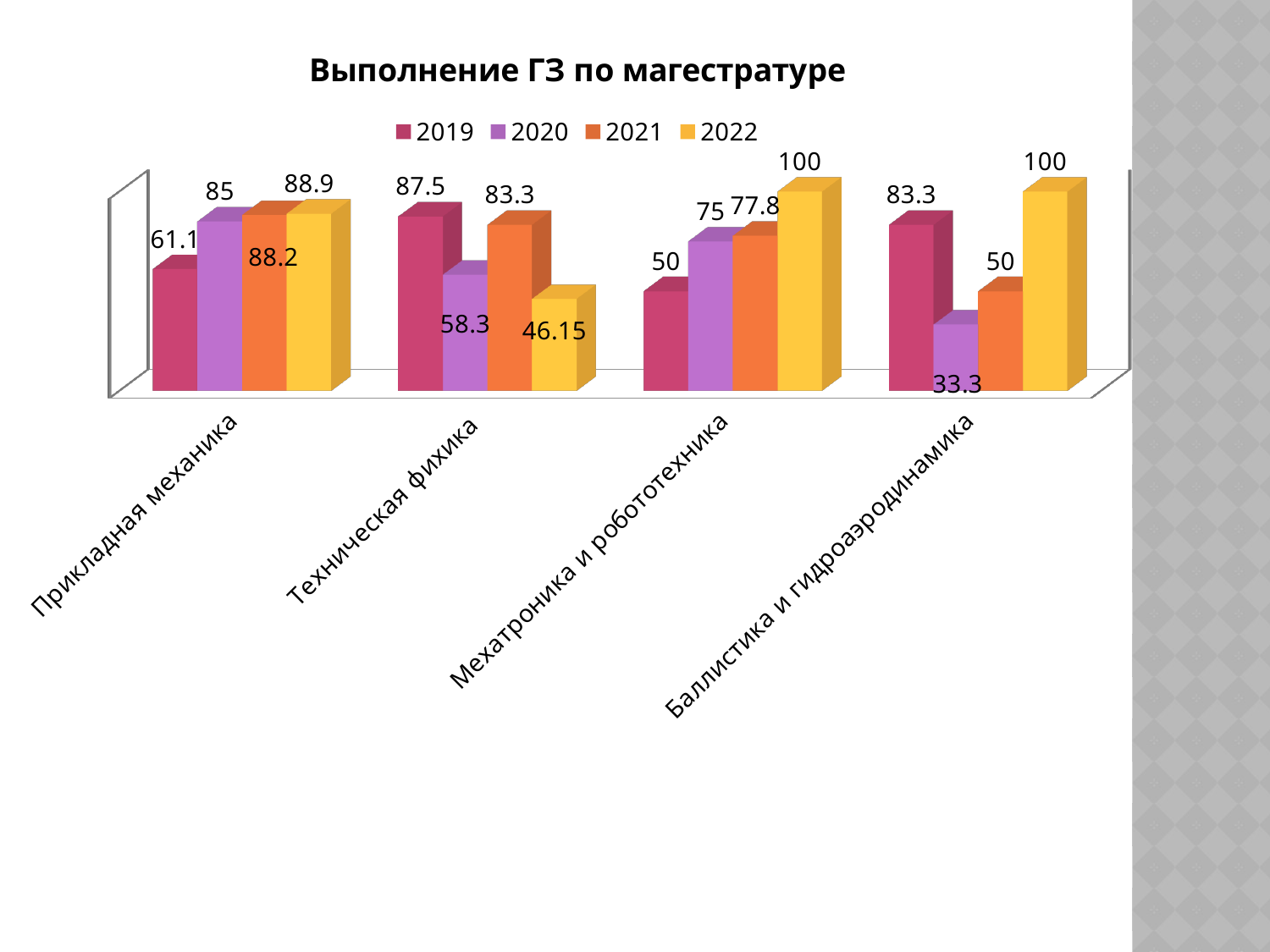
How many categories are shown on the x axis? 4 Which category has the lowest value for 2020? Баллистика и гидроаэродинамика What is the value for 2020 for Баллистика и гидроаэродинамика? 33.3 How many series does the legend list? 4 What is the value for 2019 for Прикладная механика? 61.1 What is the value for 2021 for Мехатроника и робототехника? 77.8 What is the title of the chart? Выполнение ГЗ по магестратуре Which is larger for Техническая фихика: the 2020 value or the 2021 value? 2021 What is the value for 2022 for Техническая фихика? 46.15 What is the difference between the 2022 and 2019 values for Мехатроника и робототехника? 50 Which category has the highest value for 2019? Техническая фихика What kind of chart is this? bar chart